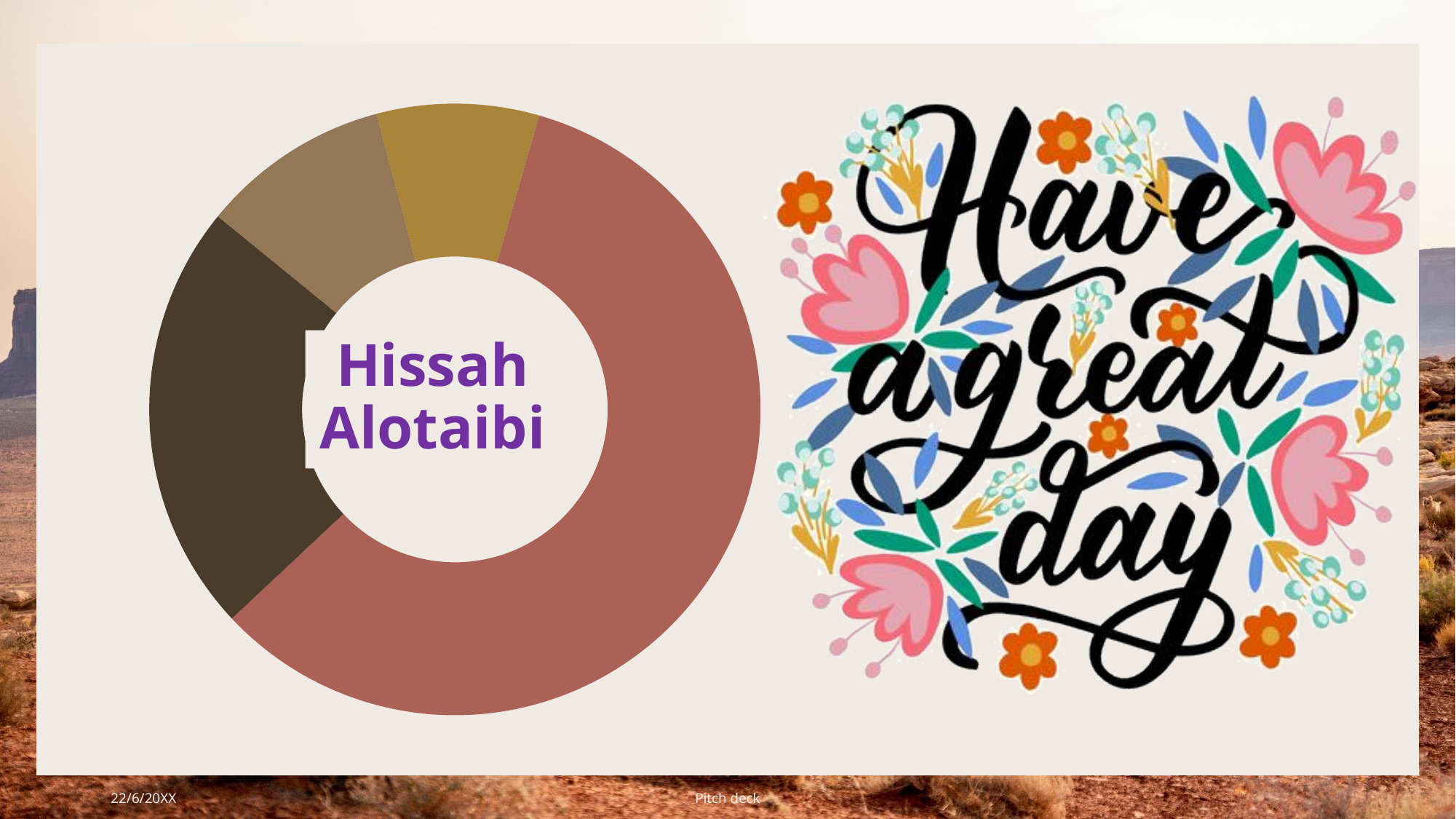
How many slices does the doughnut chart have? 4 Which slice is larger in the doughnut chart, the reddish-brown slice or the dark brown slice? The reddish-brown slice Does the doughnut chart display a legend? No What text appears in the centre of the doughnut chart? Hissah Alotaibi What kind of chart is shown on the left of the slide? Doughnut (pie) chart Which colour slice is the largest in the doughnut chart? The reddish-brown slice Which slice is larger in the doughnut chart, the dark brown slice or the gold slice? The dark brown slice